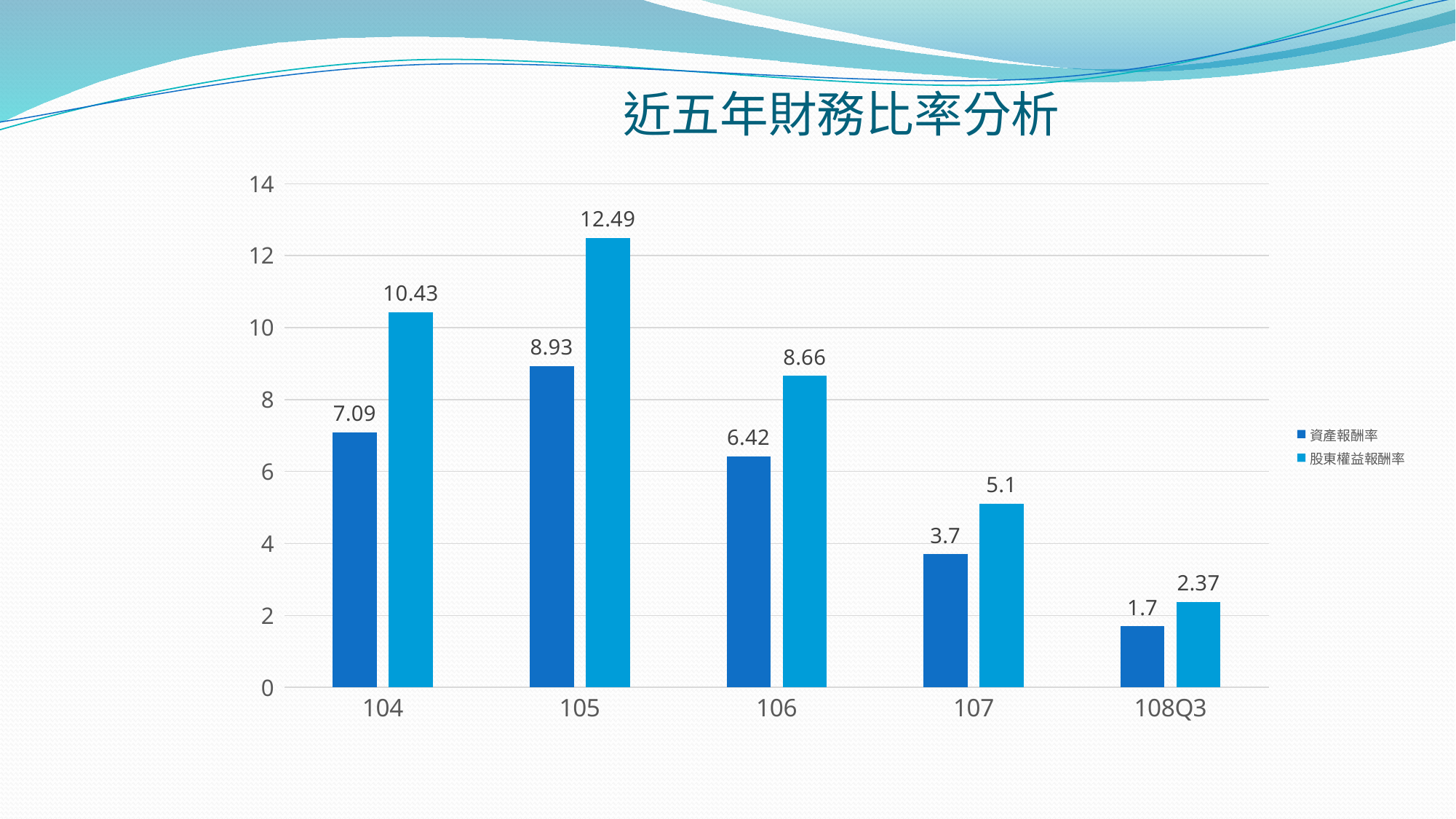
What is the 股東權益報酬率 value for 105? 12.49 Which category has the highest 股東權益報酬率? 105 Which category has the lowest 資產報酬率? 108Q3 What kind of chart is shown on the slide? bar chart Which is larger for 107: 資產報酬率 or 股東權益報酬率? 股東權益報酬率 What is the 資產報酬率 value for 104? 7.09 How many categories are shown on the x axis? 5 What is the difference between 股東權益報酬率 and 資產報酬率 for 106? 2.24 How many series does the legend list? 2 Is the 股東權益報酬率 value for 104 greater or less than 10? greater What is the 股東權益報酬率 value for 108Q3? 2.37 Does the 資產報酬率 series rise or fall from 105 to 108Q3? fall